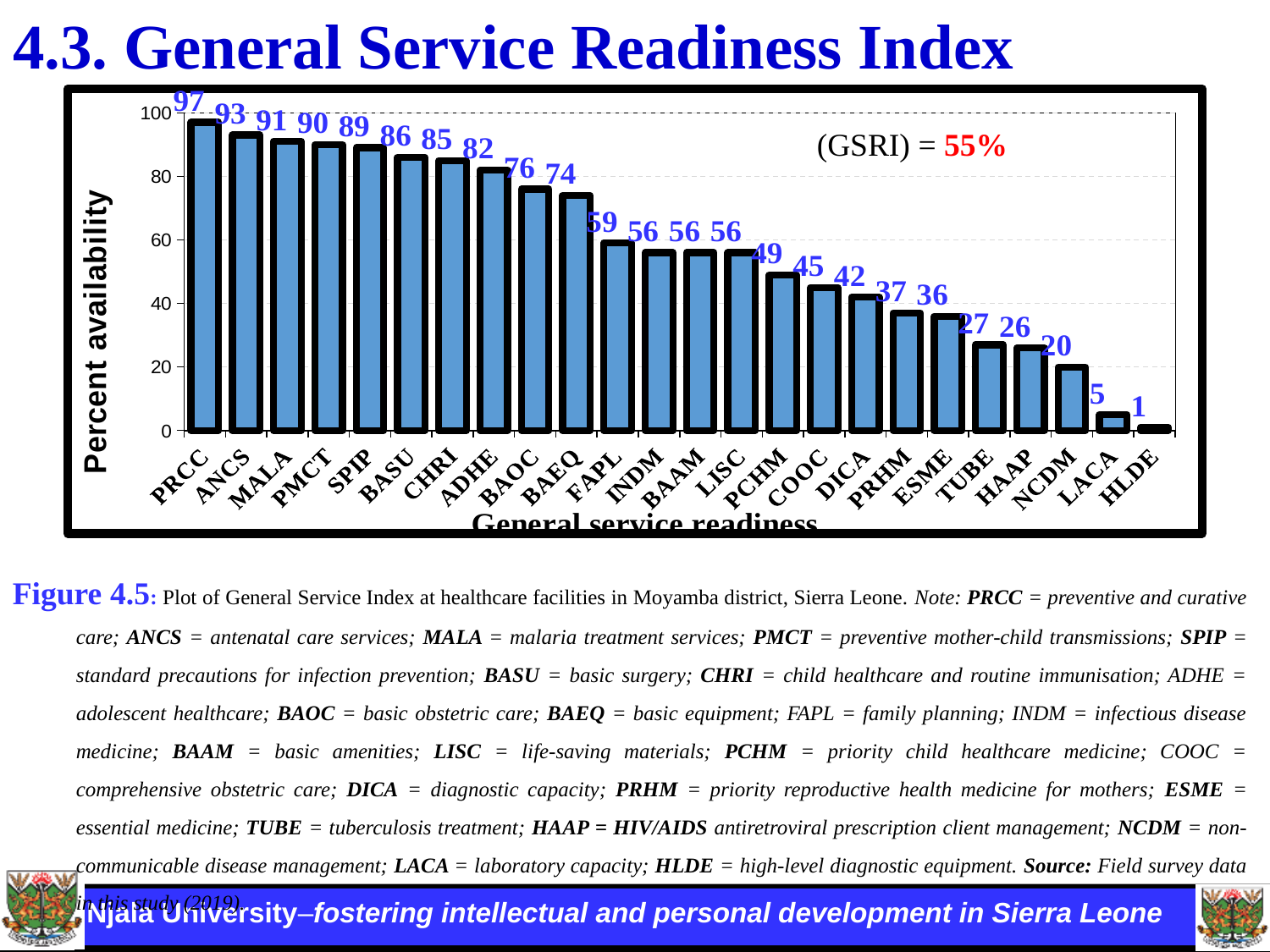
What is the value for NCDM? 20 How many categories are shown on the x axis? 24 Which is larger, the value for COOC or the value for TUBE? COOC Is the value for DICA greater or less than 40? greater What is the difference between the values for ANCS and FAPL? 34 Which category has the highest value? PRCC What is the label of the y axis? Percent availability Do the values rise or fall from left to right along the x axis? fall What kind of chart is shown? bar chart What is the value for PCHM? 49 Which category has the lowest value? HLDE What is the value for PRCC? 97